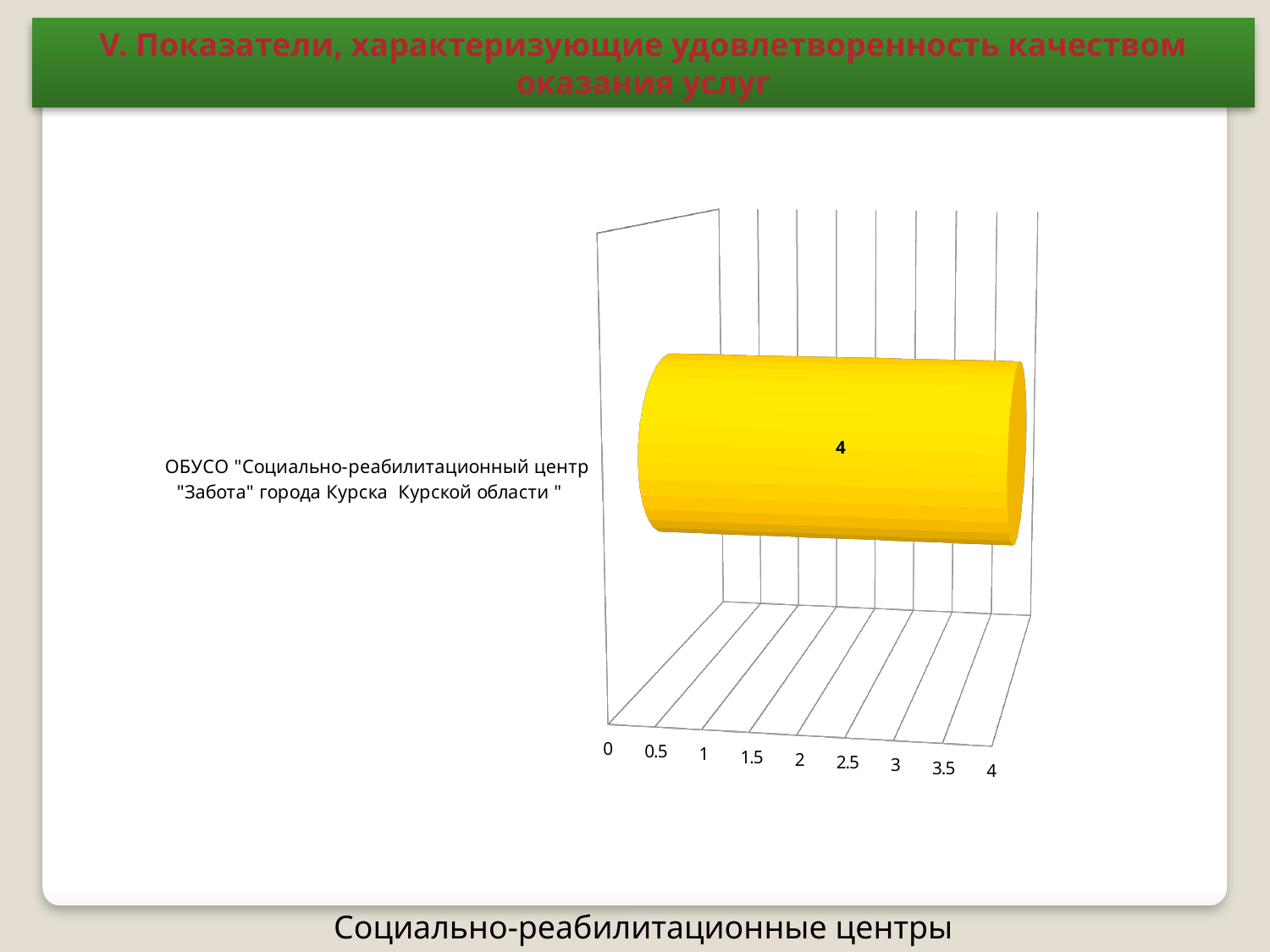
What is the highest value shown on the chart's value axis? 4 How many categories are plotted in the chart? 1 Which category has the highest value in the chart? ОБУСО "Социально-реабилитационный центр "Забота" города Курска Курской области" What is the value shown for ОБУСО "Социально-реабилитационный центр "Забота" города Курска Курской области"? 4 Is the value for ОБУСО "Социально-реабилитационный центр "Забота" greater or less than 3? greater What colour is the bar in the chart? Yellow Is the value for ОБУСО "Социально-реабилитационный центр "Забота" greater or less than 2? greater What kind of chart is shown on the slide? Bar chart Are the bars in the chart drawn horizontally or vertically? Horizontally